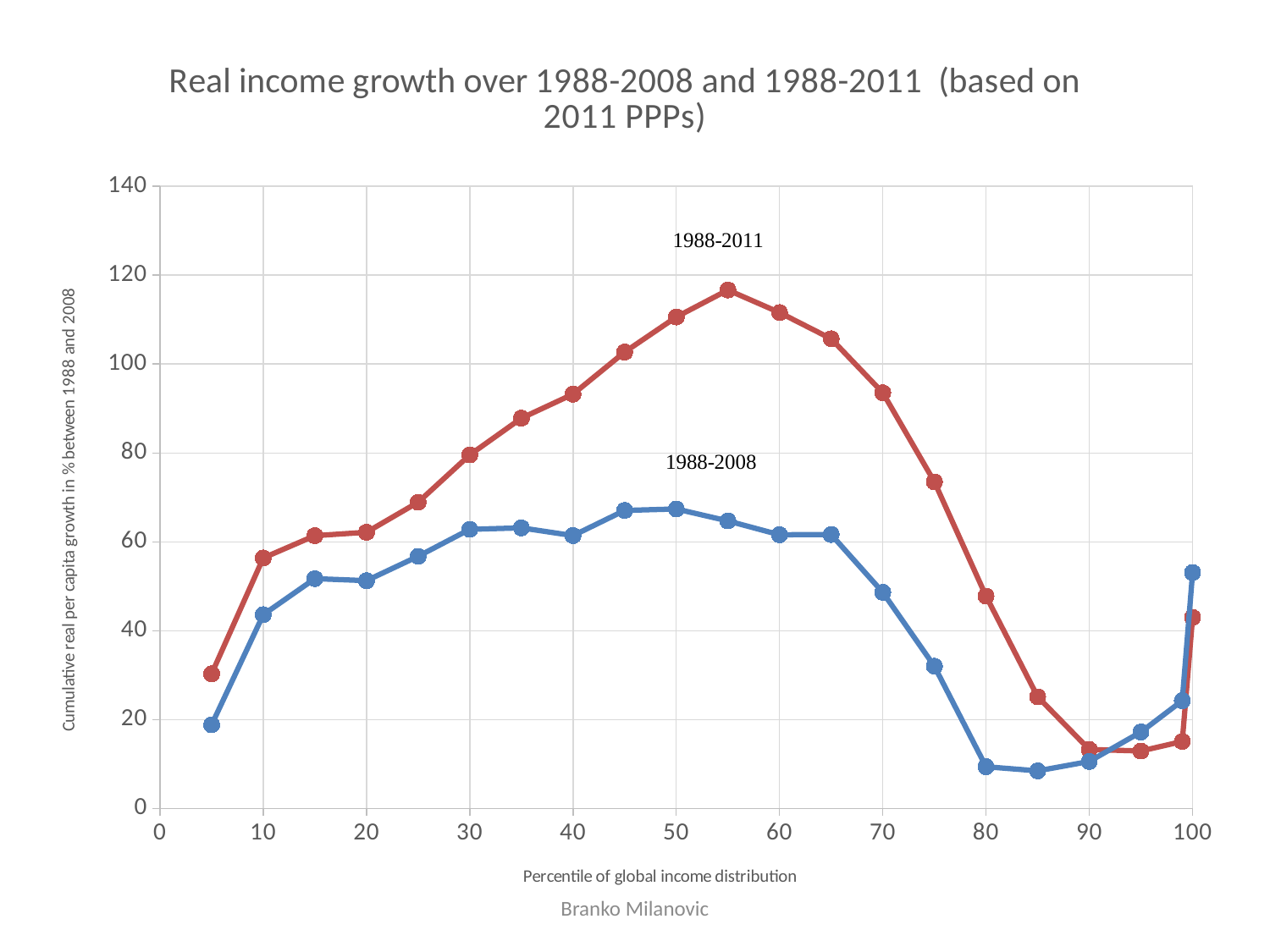
Is the value of the 1988-2008 series at percentile 100 greater or less than 40? greater At which percentile does the 1988-2011 series reach its highest value? 55 At percentile 100, which series has the larger value, 1988-2008 or 1988-2011? 1988-2008 What is the label of the x axis? Percentile of global income distribution Is the value of the 1988-2008 series at percentile 80 greater or less than 20? less Is the value of the 1988-2011 series at percentile 75 greater or less than 60? greater Does the 1988-2011 series rise or fall between percentile 55 and percentile 85? fall How many series are plotted on the chart? 2 Does the 1988-2008 series rise or fall between percentile 5 and percentile 30? rise What kind of chart is shown on the slide? line chart At percentile 50, which series has the larger value, 1988-2008 or 1988-2011? 1988-2011